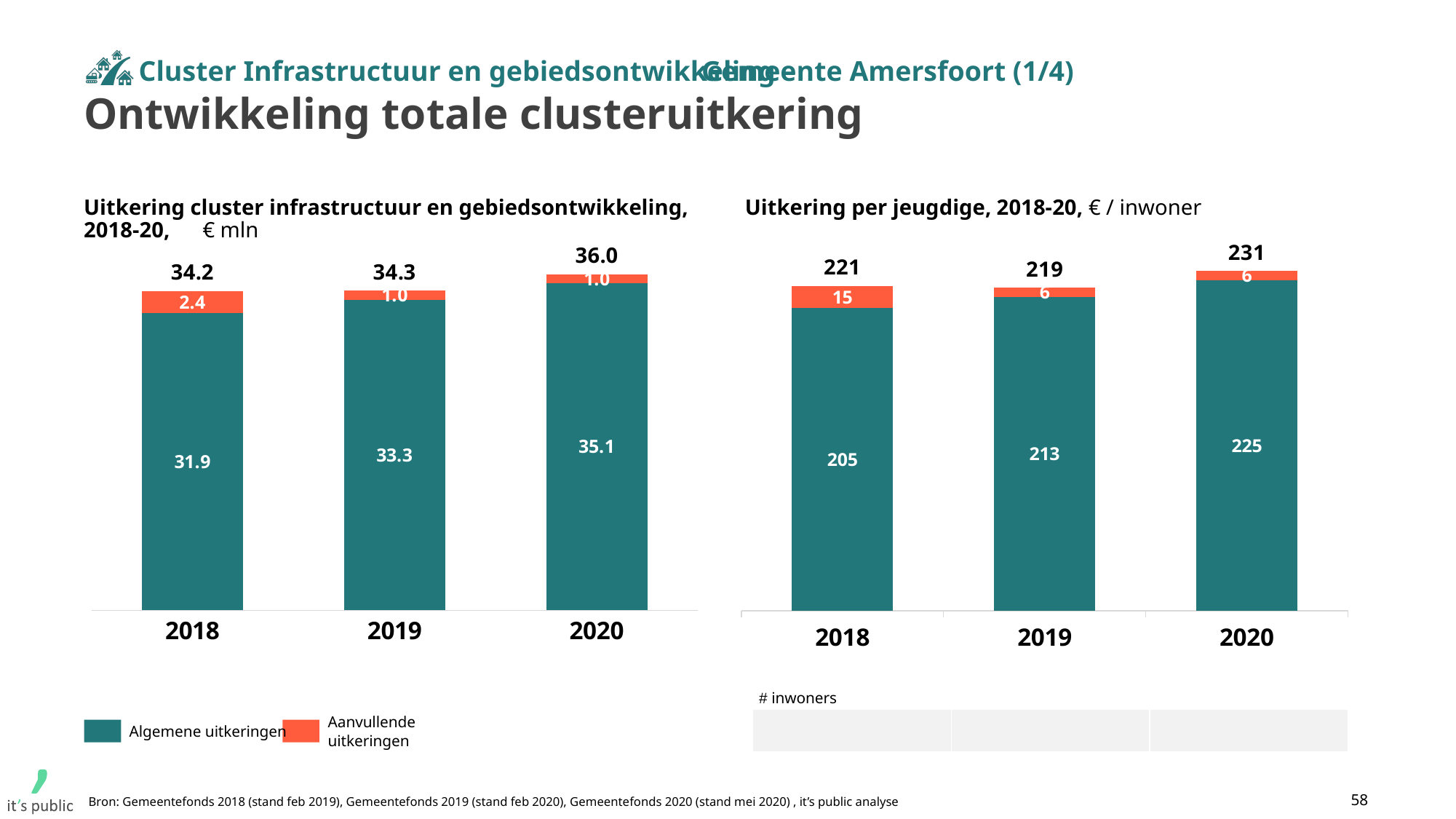
In the left chart (Uitkering cluster infrastructuur en gebiedsontwikkeling), what is the value of Algemene uitkeringen for 2019? 33.3 In the right chart (Uitkering per jeugdige), what is the value of Aanvullende uitkeringen for 2018? 15 In the left chart (Uitkering cluster infrastructuur en gebiedsontwikkeling), which year has the highest total uitkering? 2020 In the right chart (Uitkering per jeugdige), what is the value of Algemene uitkeringen for 2020? 225 In the right chart (Uitkering per jeugdige), what is the difference between the totals for 2020 and 2019? 12 In the left chart (Uitkering cluster infrastructuur en gebiedsontwikkeling), what is the difference between the Algemene uitkeringen for 2020 and 2018? 3.2 What kind of chart is the left chart (Uitkering cluster infrastructuur en gebiedsontwikkeling)? stacked bar chart In the right chart (Uitkering per jeugdige), which year has the lowest total? 2019 In the left chart (Uitkering cluster infrastructuur en gebiedsontwikkeling), do the Algemene uitkeringen rise or fall from 2018 to 2020? rise How many series does the legend list for the charts on this slide? 2 In the left chart (Uitkering cluster infrastructuur en gebiedsontwikkeling), what is the total of the stacked bar for 2020? 36.0 In the left chart (Uitkering cluster infrastructuur en gebiedsontwikkeling), what is the value of Aanvullende uitkeringen for 2018? 2.4